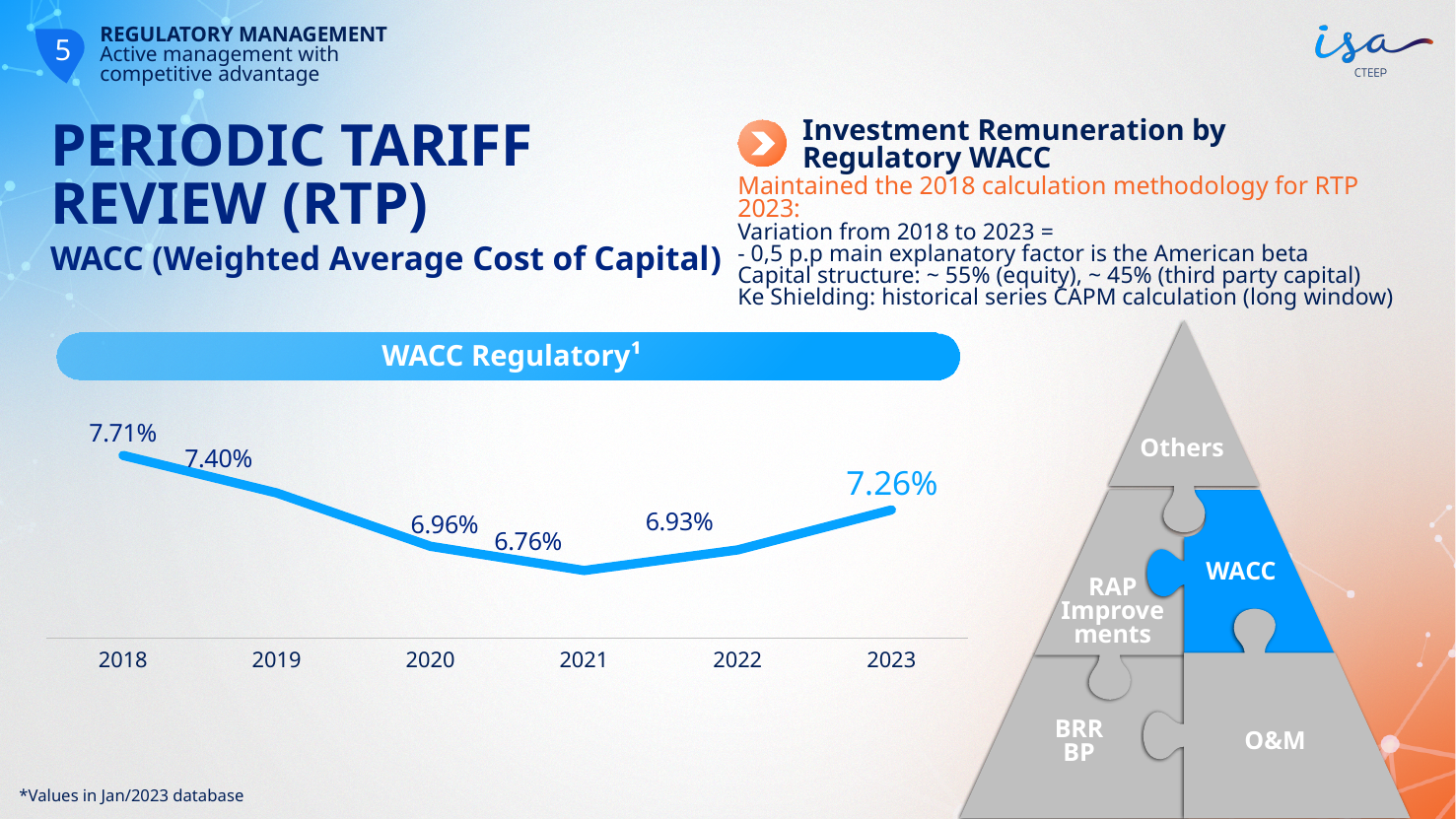
What is the WACC Regulatory value for 2020? 6.96% What is the WACC Regulatory value for 2018? 7.71% How many years are plotted in the WACC Regulatory chart? 6 Which year has the lowest WACC Regulatory value? 2021 Which is larger, the WACC Regulatory value for 2022 or for 2023? 2023 What is the difference between the WACC Regulatory values for 2019 and 2020? 0.44% Does the WACC Regulatory value rise or fall from 2018 to 2021? Fall What kind of chart is the WACC Regulatory chart? Line chart What is the WACC Regulatory value for 2021? 6.76% What is the difference between the WACC Regulatory values for 2018 and 2023? 0.45% Which year has the highest WACC Regulatory value? 2018 What is the WACC Regulatory value for 2023? 7.26%